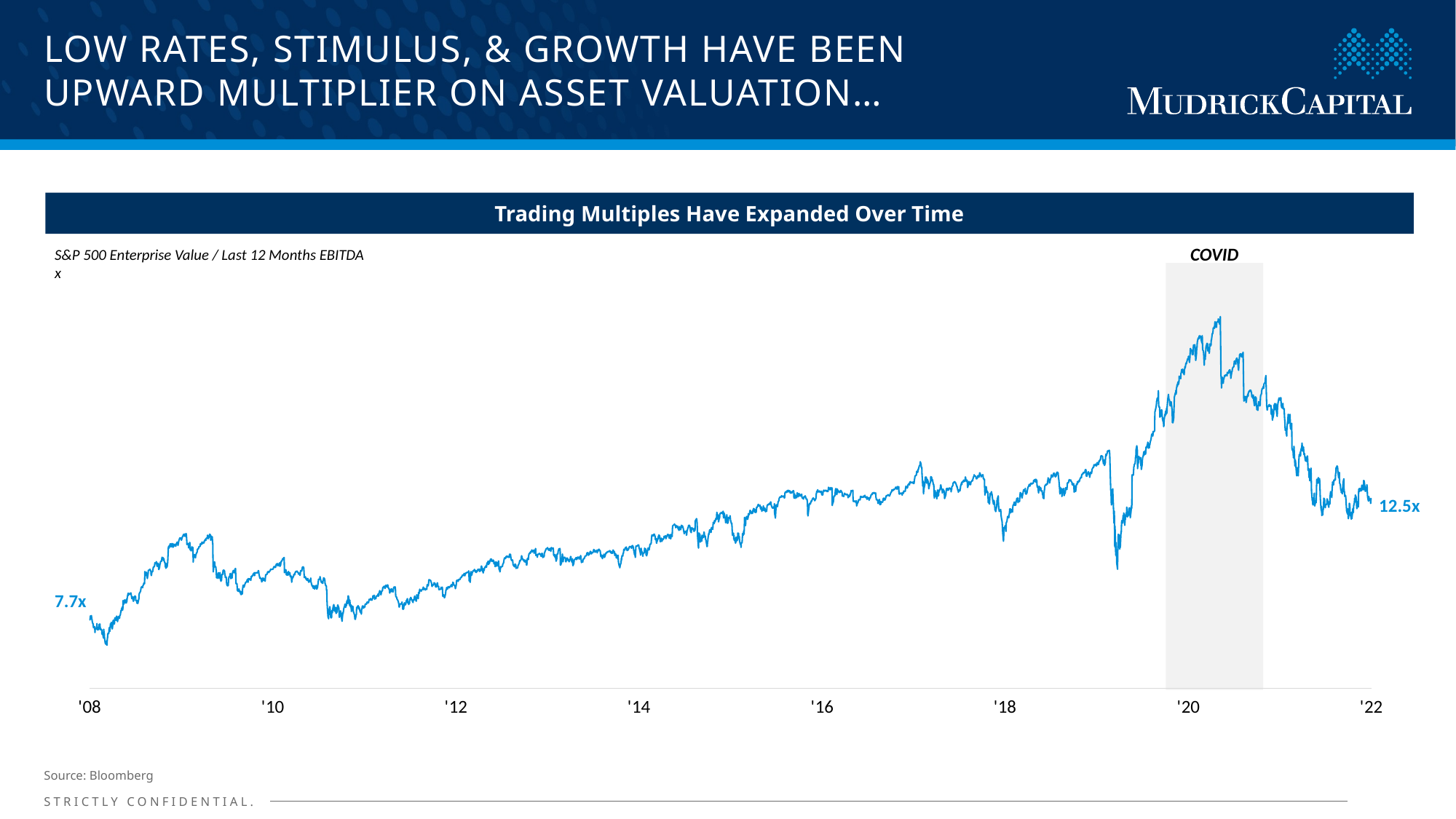
Does the line fall or rise between the COVID shaded region and '22? Fall What is the title of the chart? Trading Multiples Have Expanded Over Time What kind of chart is shown on the slide? Line chart During which labelled shaded period does the line reach its highest point? COVID By how much does the end value (12.5x) exceed the start value (7.7x)? 4.8x How many year labels are shown on the x axis? 8 What is the value shown at the end of the line in '22? 12.5x What is the value shown at the start of the line in '08? 7.7x Which is larger, the value labelled at '08 or the value labelled at '22? '22 (12.5x) What metric does the chart plot, according to the label above the line? S&P 500 Enterprise Value / Last 12 Months EBITDA Overall, does the line rise or fall from '08 to '22? Rise